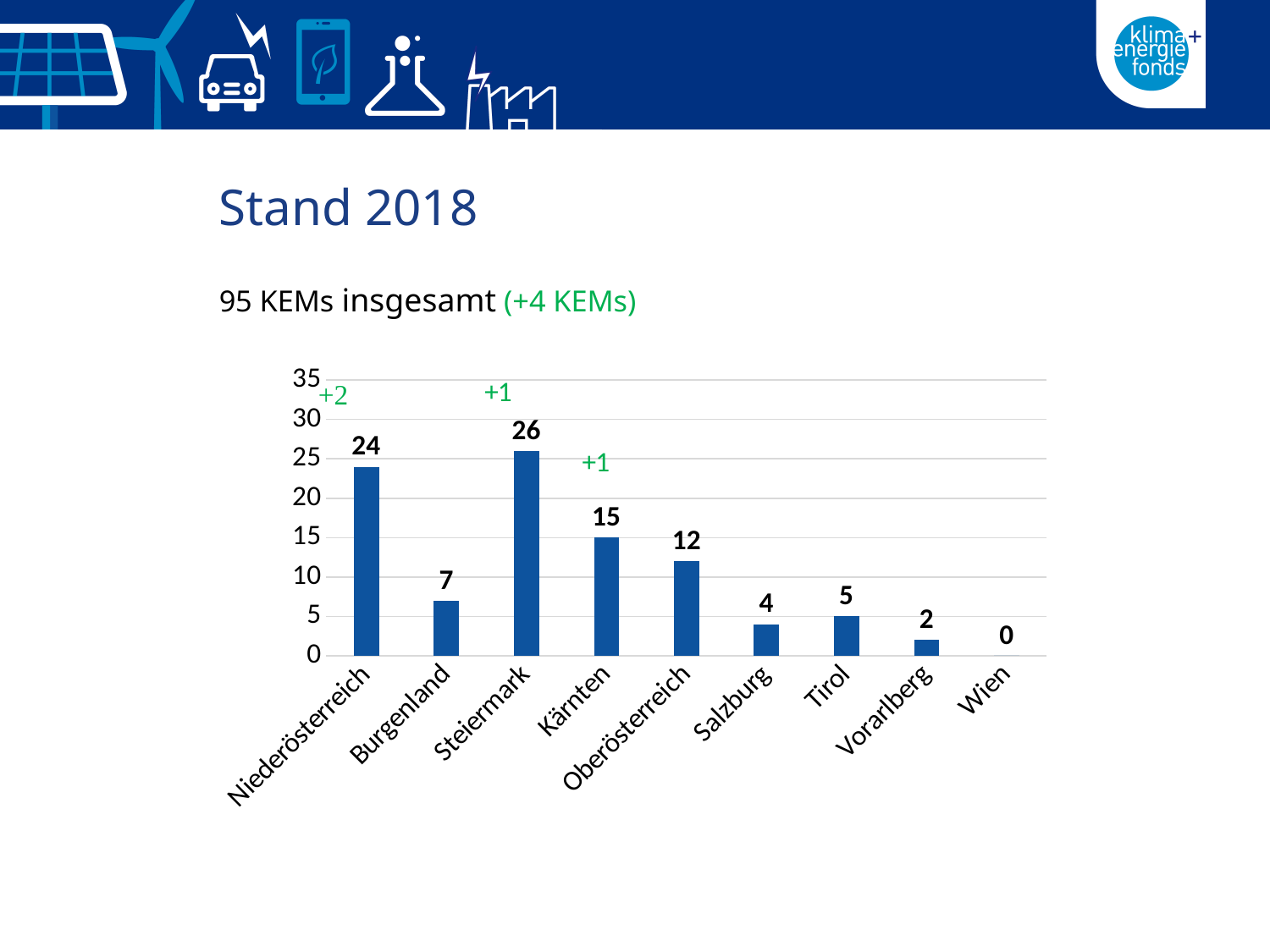
What is the value for Vorarlberg? 2 What is the difference between the values for Niederösterreich and Oberösterreich? 12 What is the value for Steiermark? 26 How many categories are shown on the x axis? 9 Which category has the highest value? Steiermark What green annotation is shown above the Niederösterreich bar? +2 Which is larger, the value for Burgenland or the value for Tirol? Burgenland Which category has the lowest value? Wien What kind of chart is shown on the slide? bar chart What is the title of the slide? Stand 2018 What is the value for Kärnten? 15 Is the value for Niederösterreich greater or less than 20? greater